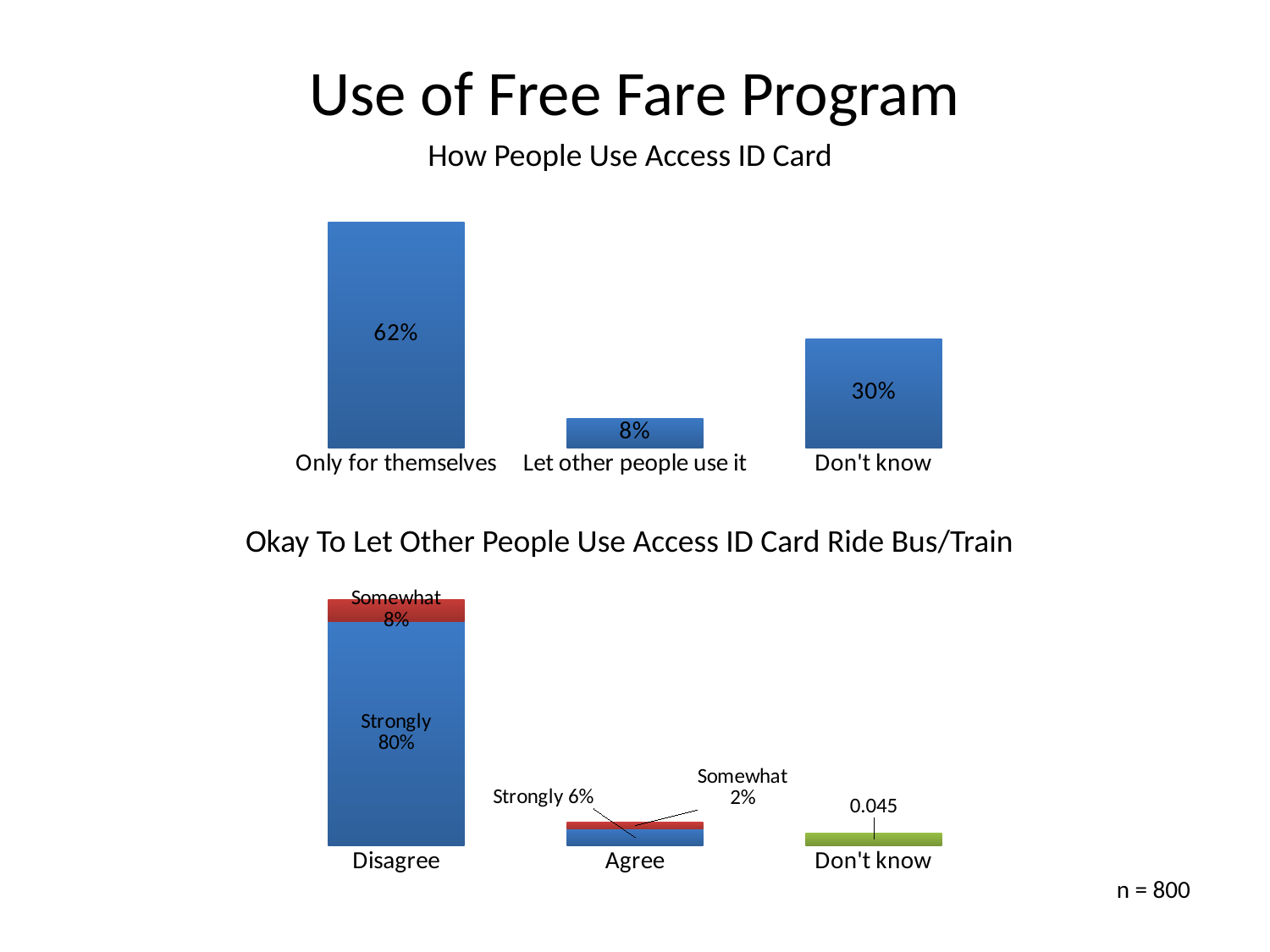
In the 'How People Use Access ID Card' chart, which category has the highest value? Only for themselves In the 'Okay To Let Other People Use Access ID Card Ride Bus/Train' chart, what is the 'Somewhat' value for Agree? 2% In the 'Okay To Let Other People Use Access ID Card Ride Bus/Train' chart, what value is labelled on the 'Don't know' bar? 0.045 In the 'How People Use Access ID Card' chart, what percentage is shown for 'Let other people use it'? 8% In the 'Okay To Let Other People Use Access ID Card Ride Bus/Train' chart, what is the total of the Disagree bar (Strongly plus Somewhat)? 88% In the 'How People Use Access ID Card' chart, what percentage is shown for 'Only for themselves'? 62% In the 'How People Use Access ID Card' chart, which category has the lowest value? Let other people use it In the 'Okay To Let Other People Use Access ID Card Ride Bus/Train' chart, what is the 'Strongly' value for Disagree? 80% In the 'How People Use Access ID Card' chart, what percentage is shown for 'Don't know'? 30% What type of chart is the 'Okay To Let Other People Use Access ID Card Ride Bus/Train' chart? Stacked bar chart How many categories are shown in the 'How People Use Access ID Card' chart? 3 In the 'How People Use Access ID Card' chart, what is the difference between 'Only for themselves' and 'Don't know'? 32%